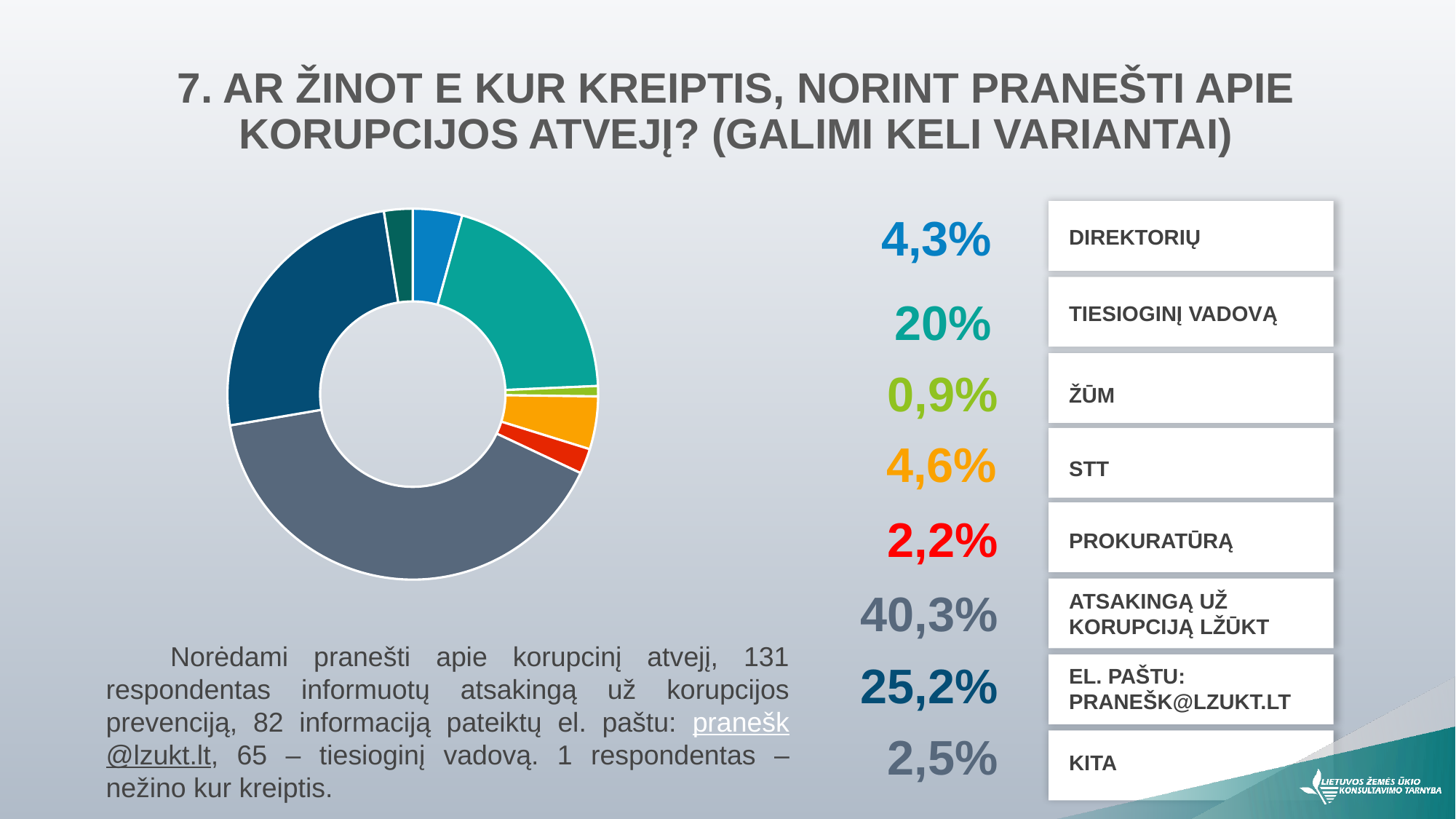
What is the difference between the values for ATSAKINGĄ UŽ KORUPCIJĄ LŽŪKT and EL. PAŠTU: PRANEŠK@LZUKT.LT? 15,1% What is the value for ATSAKINGĄ UŽ KORUPCIJĄ LŽŪKT? 40,3% What kind of chart is shown on the slide? Pie (donut) chart Which category has the smallest share? ŽŪM What is the value for TIESIOGINĮ VADOVĄ? 20% Which category has the largest share? ATSAKINGĄ UŽ KORUPCIJĄ LŽŪKT What is the difference between the values for TIESIOGINĮ VADOVĄ and PROKURATŪRĄ? 17,8% What colour is the slice for PROKURATŪRĄ? Red Which is larger, the value for STT or the value for DIREKTORIŲ? STT What is the value for STT? 4,6% What is the value for EL. PAŠTU: PRANEŠK@LZUKT.LT? 25,2% How many categories does the chart show? 8